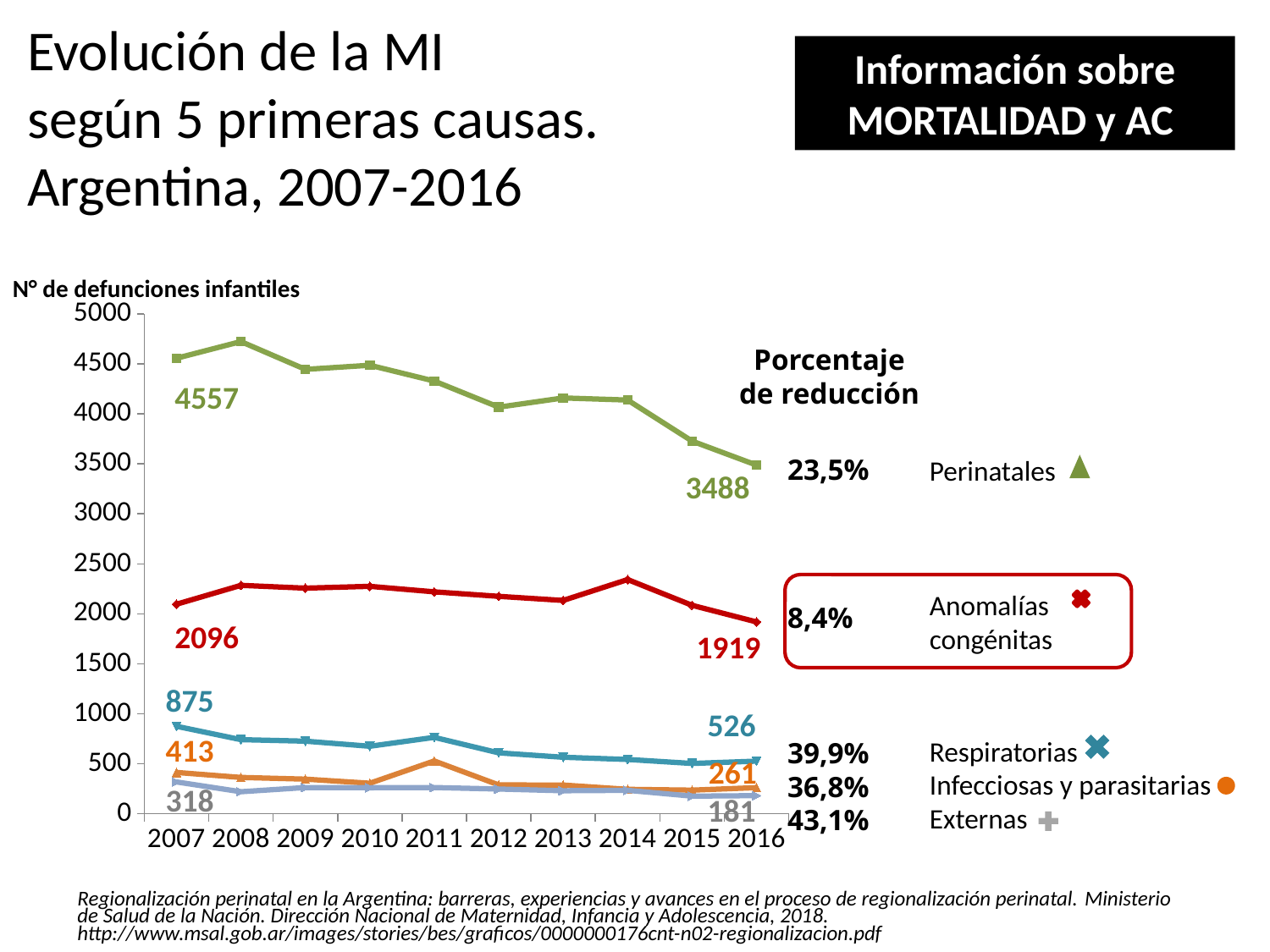
Which cause had the lowest number of infant deaths in 2007? Externas What was the number of infant deaths from Anomalías congénitas in 2016? 1919 What type of chart is shown on the slide? Line chart What is the percentage reduction shown for Anomalías congénitas? 8,4% By how much did infant deaths from Perinatales causes fall between 2007 and 2016? 1069 What was the number of infant deaths from Respiratorias causes in 2007? 875 Which cause had the highest number of infant deaths in 2016? Perinatales What was the number of infant deaths from Externas causes in 2016? 181 What was the number of infant deaths from Perinatales causes in 2007? 4557 How many years are plotted along the x axis? 10 Which cause shows the largest percentage reduction (Porcentaje de reducción)? Externas (43,1%) How many series (causes) are plotted in the chart? 5